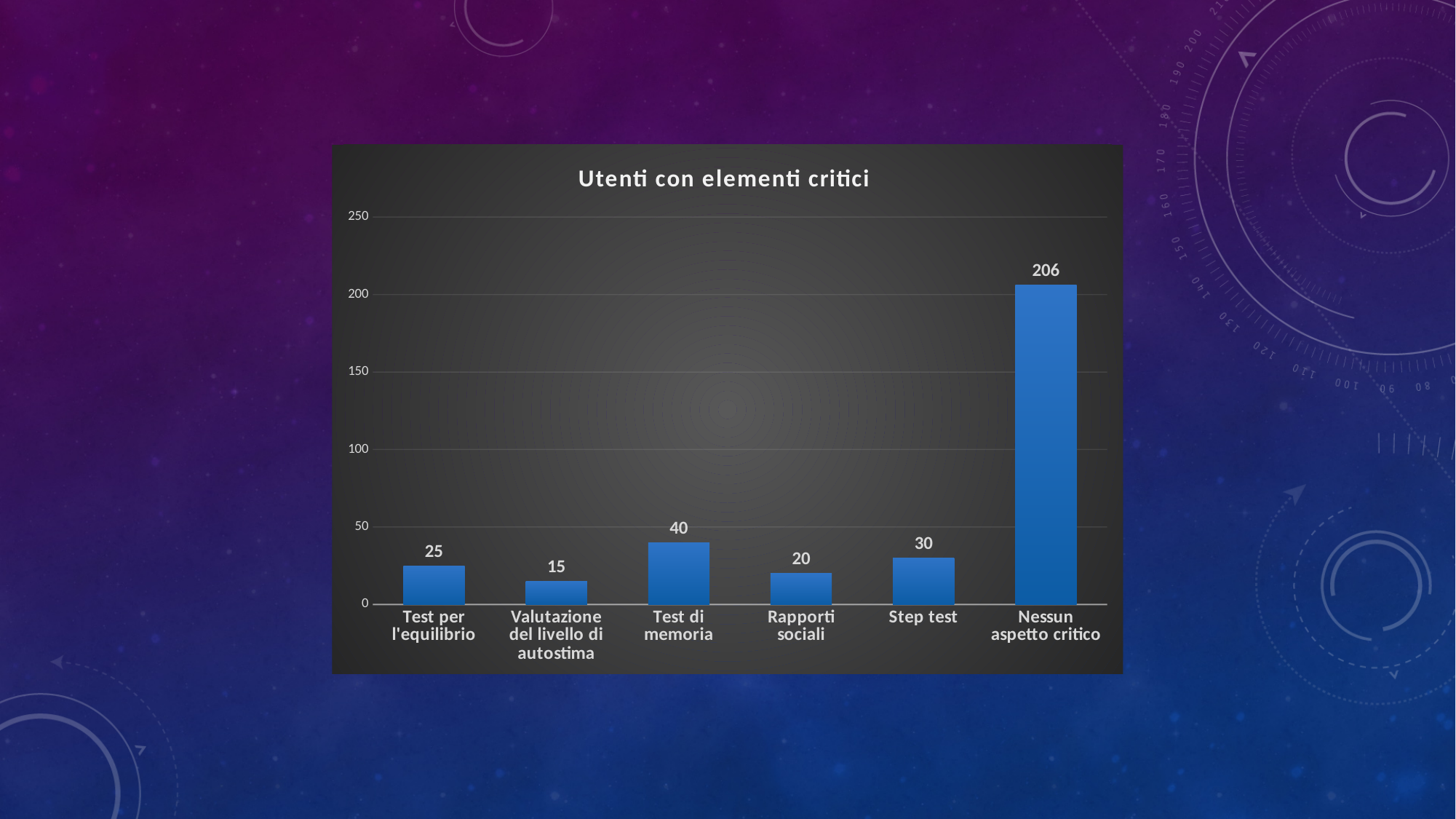
What is the value for Nessun aspetto critico? 206 What is the difference between the values for Test di memoria and Rapporti sociali? 20 What is the value for Step test? 30 What kind of chart is shown? bar chart Which category has the highest value? Nessun aspetto critico Which category has the lowest value? Valutazione del livello di autostima What is the title of the chart? Utenti con elementi critici Is the value for Nessun aspetto critico greater or less than 200? greater How many categories are shown on the x axis? 6 What is the value for Test di memoria? 40 What is the value for Valutazione del livello di autostima? 15 Which is larger, the value for Test per l'equilibrio or the value for Step test? Step test